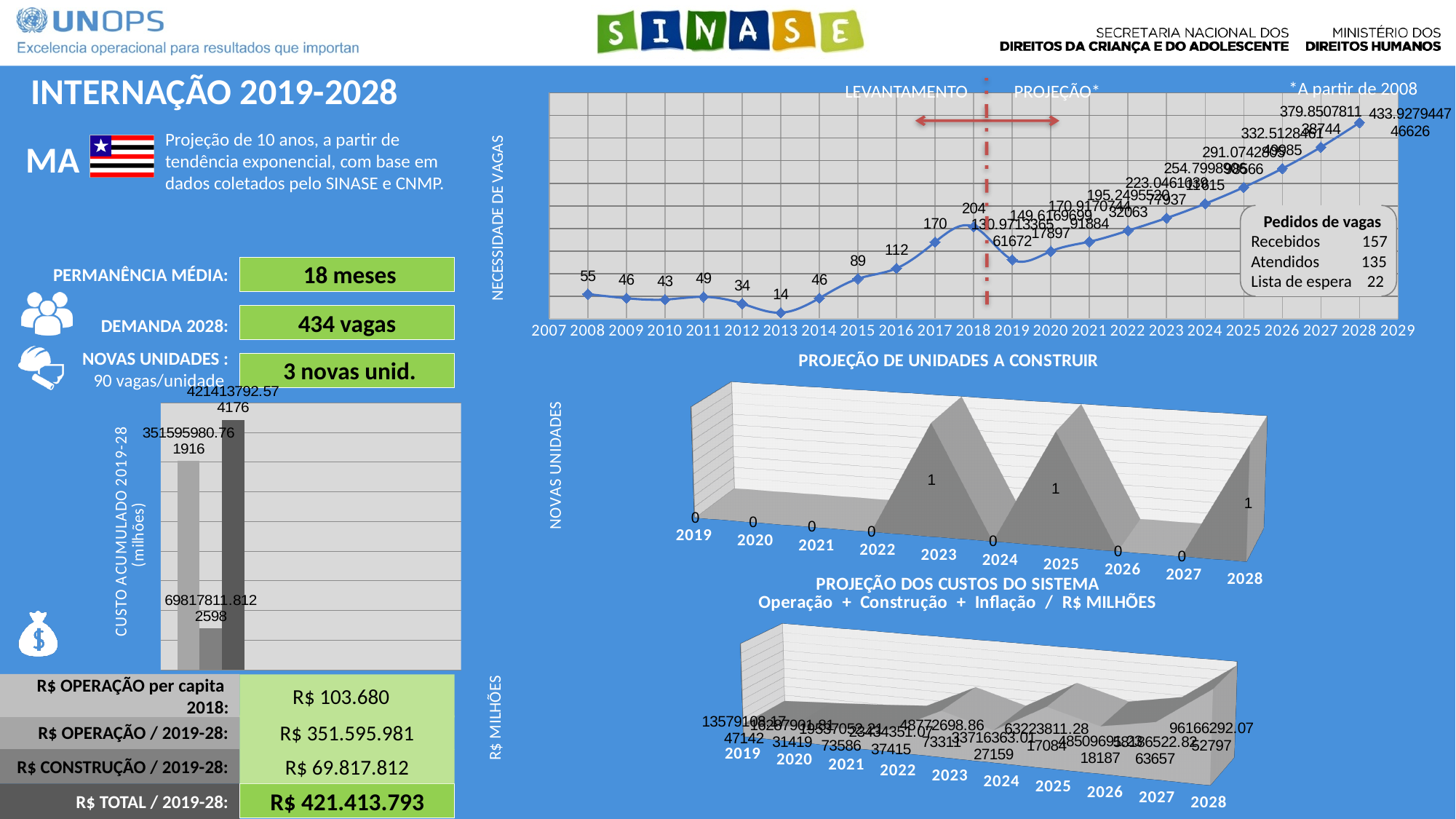
In the NECESSIDADE DE VAGAS line chart, what is the difference between the values for 2018 and 2017? 34 In the NECESSIDADE DE VAGAS line chart, what is the value for 2008? 55 In the NECESSIDADE DE VAGAS line chart, which year has the larger value, 2015 or 2016? 2016 In the NECESSIDADE DE VAGAS line chart, do the values rise or fall from 2013 to 2018? rise In the NECESSIDADE DE VAGAS chart, how many requests are listed as 'Recebidos' in the Pedidos de vagas box? 157 In the PROJEÇÃO DE UNIDADES A CONSTRUIR chart, how many years are shown on the x axis? 10 What kind of chart is the CUSTO ACUMULADO 2019-28 chart on the left of the slide? bar chart In the PROJEÇÃO DE UNIDADES A CONSTRUIR chart, what is the value for 2023? 1 In the NECESSIDADE DE VAGAS line chart, what is the value for 2013? 14 In the NECESSIDADE DE VAGAS line chart, which year has the highest value? 2028 In the NECESSIDADE DE VAGAS line chart, which year has the lowest value? 2013 In the NECESSIDADE DE VAGAS line chart, what is the value for 2018? 204